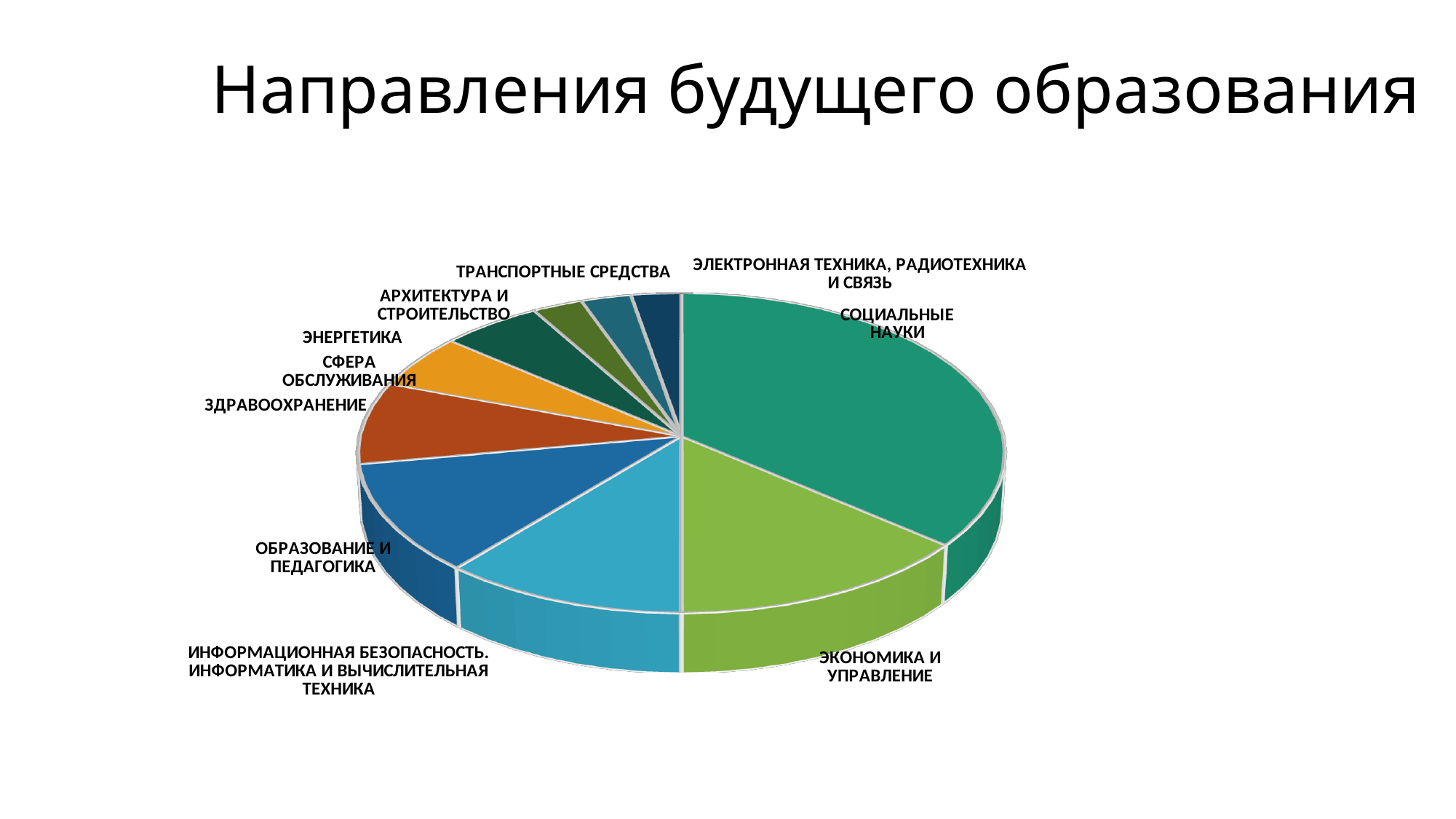
What is the title of the slide? Направления будущего образования What colour is the slice for Сфера обслуживания? Orange Which slice is larger: Экономика и управление or Транспортные средства? Экономика и управление How many categories (slices) does the pie chart have? 10 Which slice is larger: Образование и педагогика or Здравоохранение? Образование и педагогика Which category has the largest slice of the pie chart? Социальные науки What kind of chart is shown on the slide? Pie chart Which slice is larger: Информационная безопасность. Информатика и вычислительная техника or Сфера обслуживания? Информационная безопасность. Информатика и вычислительная техника